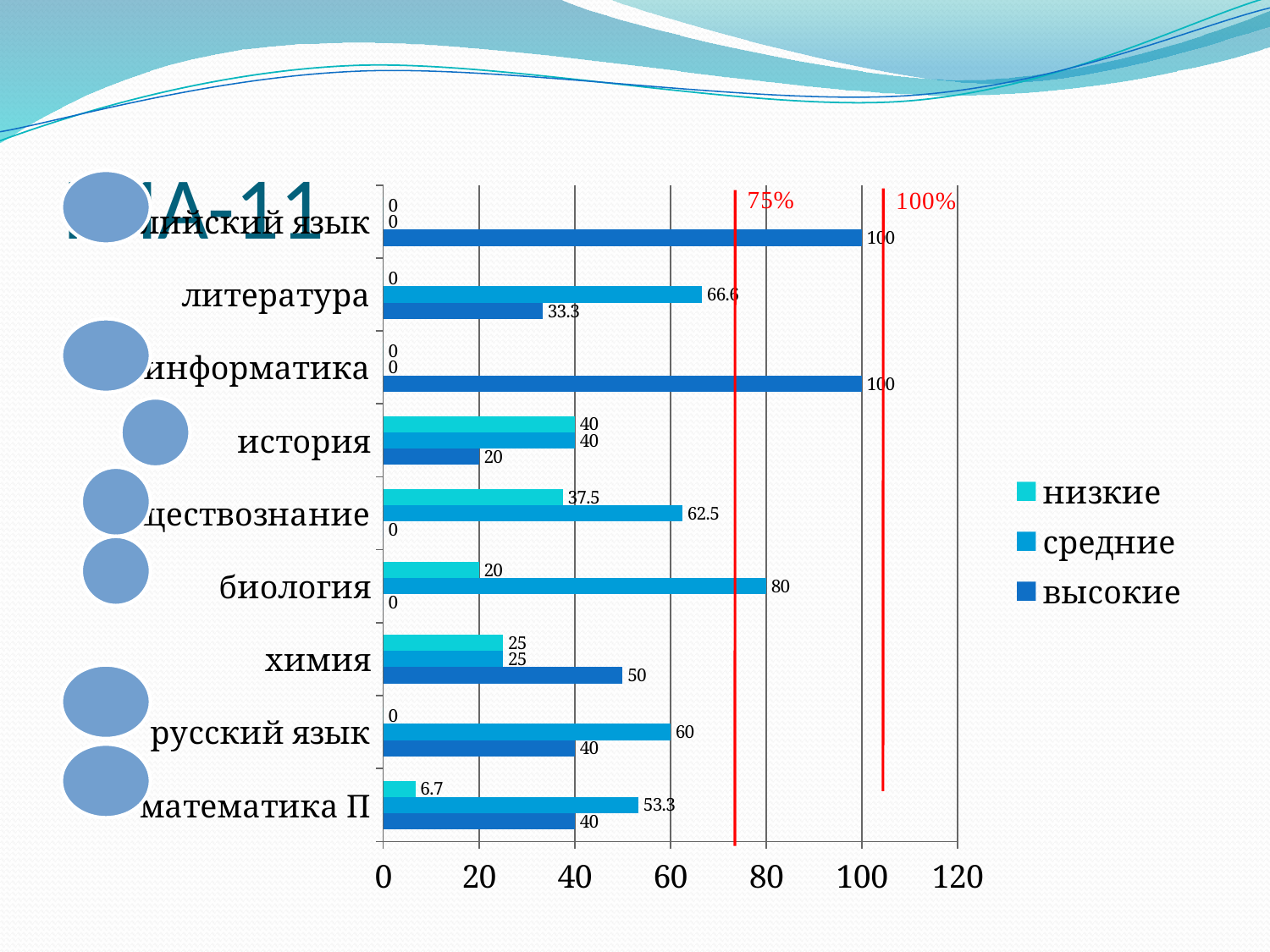
What is the value of the высокие series for химия? 50 What kind of chart is shown on the slide? bar chart What is the total of the three values for химия? 100 What is the value of the средние series for литература? 66.6 Which category has the highest value in the средние series? биология What is the value of the низкие series for математика П? 6.7 For русский язык, which is larger: the средние value or the высокие value? средние What is the value of the средние series for биология? 80 How many categories are shown on the chart? 9 How many series does the legend list? 3 What are the three series names listed in the legend? низкие, средние, высокие For история, what is the difference between the средние value and the высокие value? 20